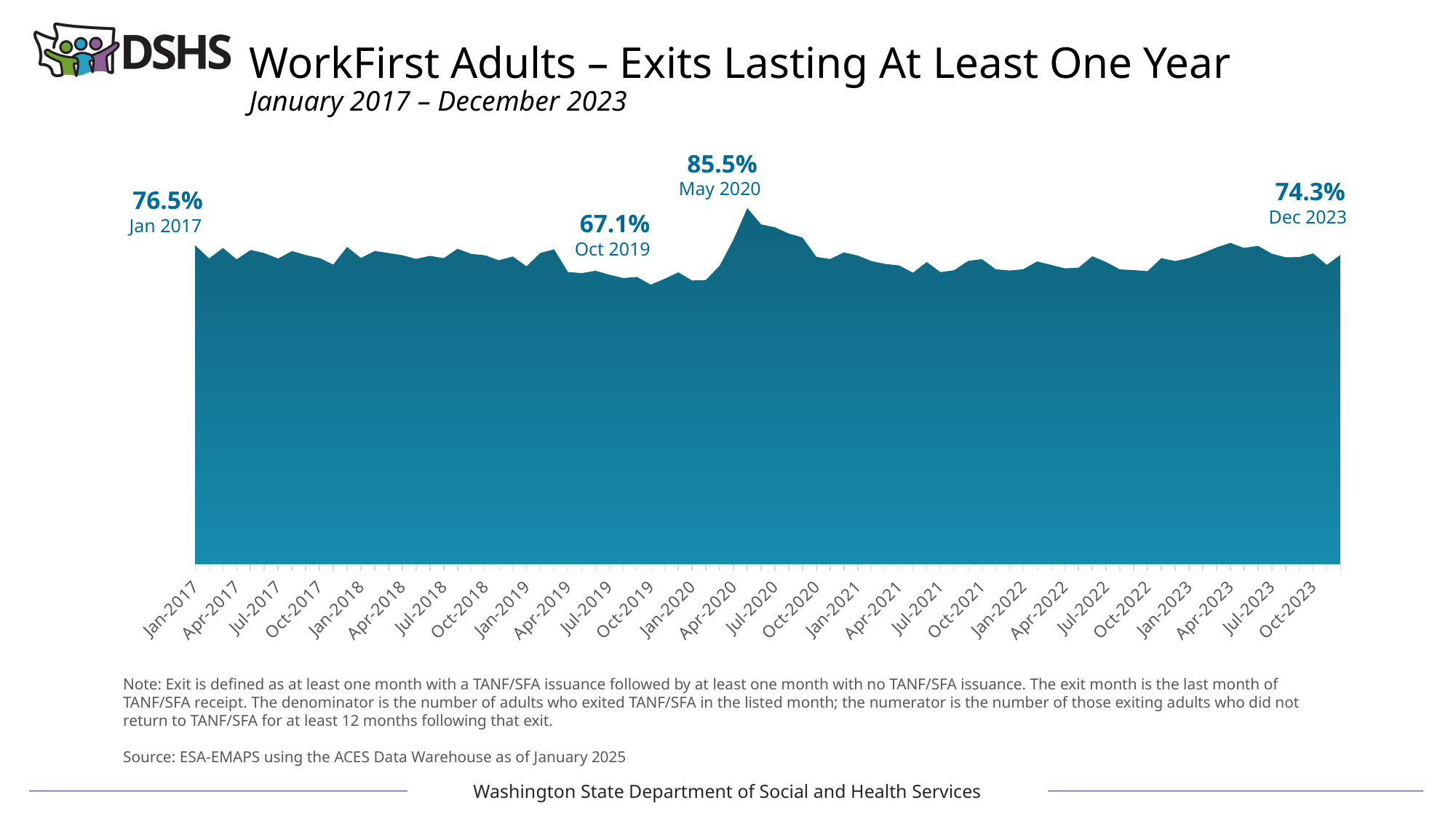
What is the value labeled for Jan 2017? 76.5% What is the difference between the Jan 2017 value and the Dec 2023 value? 2.2 percentage points Which is larger, the value for Jan 2017 or the value for Dec 2023? Jan 2017 Which month has the highest value on the chart? May 2020 What is the value labeled for Oct 2019? 67.1% What is the difference between the May 2020 value and the Oct 2019 value? 18.4 percentage points Which of the labeled points has the lowest value? Oct 2019 What is the value labeled for May 2020? 85.5% What kind of chart is shown on the slide? Area chart What period does the chart subtitle say the data covers? January 2017 – December 2023 What is the value labeled for Dec 2023? 74.3% Does the value rise or fall from Jan 2017 to Dec 2023 overall? Fall